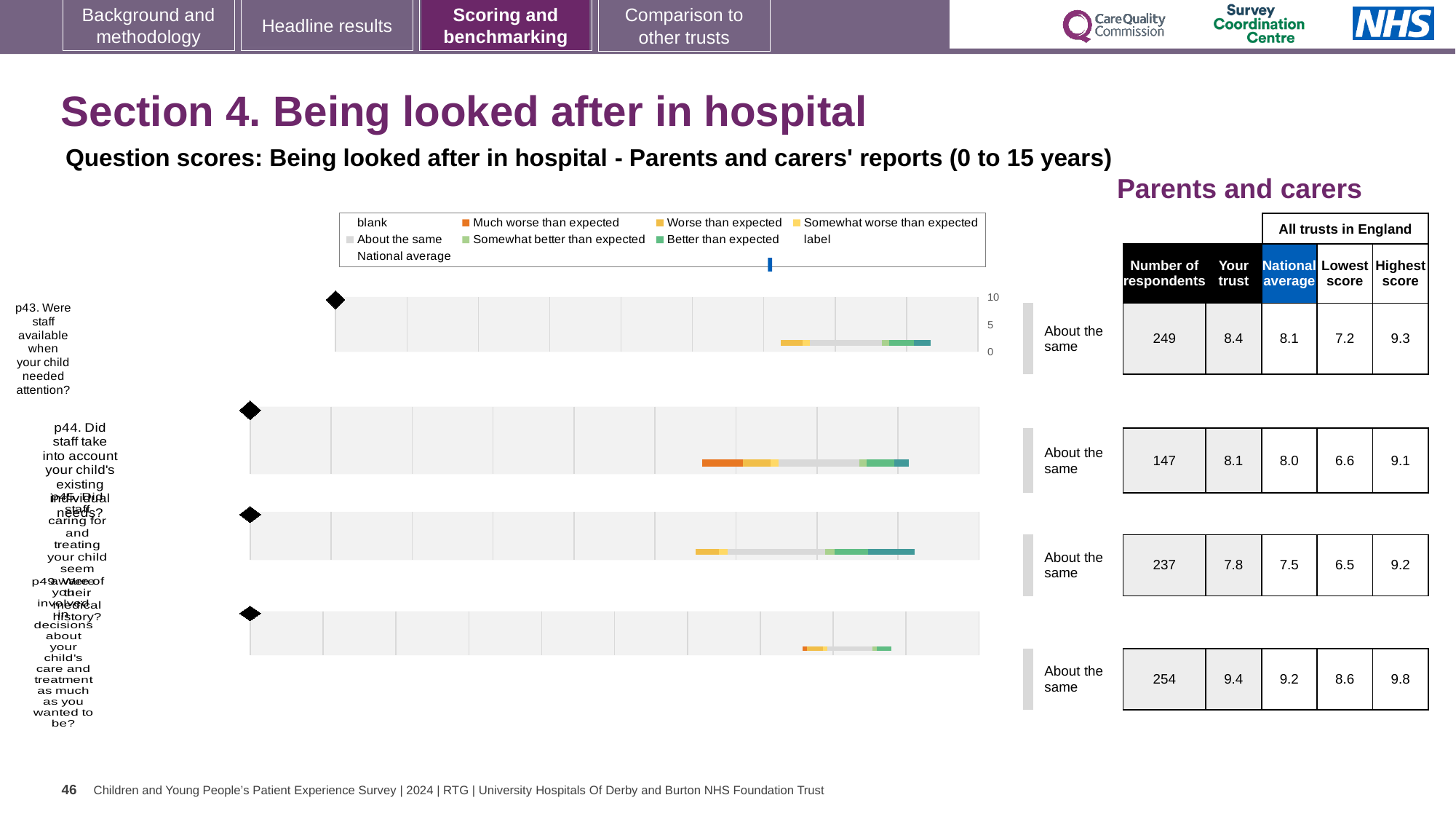
How many respondents are recorded for p45 (Did staff caring for and treating your child seem aware of their medical history?)? 237 Which question has the lowest 'Your trust' score? p45 How many question rows (charts) are shown on the slide? 4 For p49, what is the difference between the highest score and the lowest score across all trusts in England? 1.2 Which question has the highest 'Your trust' score? p49 What benchmark category is shown for p43 (Were staff available when your child needed attention?)? About the same For p43 (Were staff available when your child needed attention?), what is the 'Your trust' score? 8.4 For p43, what is the difference between the 'Your trust' score and the national average? 0.3 For p44 (Did staff take into account your child's existing individual needs?), which is larger: the 'Your trust' score or the national average? Your trust What kind of chart is used to show the question scores on this slide? bar chart For p49 (Were you involved in decisions about your child's care and treatment as much as you wanted to be?), what is the national average score? 9.2